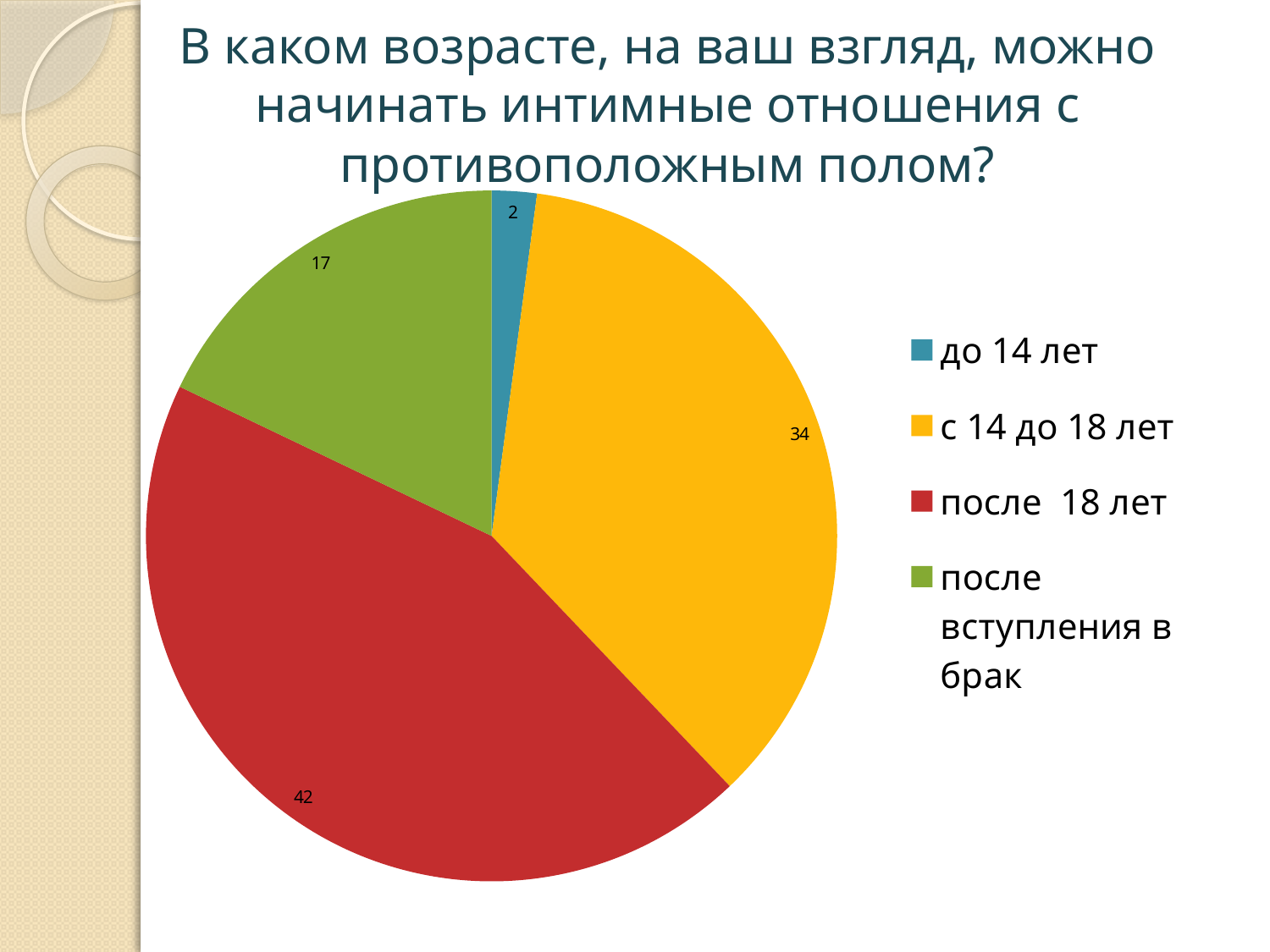
What colour is the slice for "после 18 лет"? red What value is shown for the slice "после вступления в брак"? 17 What kind of chart is shown on the slide? pie chart What value is shown for the slice "с 14 до 18 лет"? 34 What is the difference between the values for "после вступления в брак" and "до 14 лет"? 15 What value is shown for the slice "до 14 лет"? 2 Which category has the smallest slice of the pie? до 14 лет How many slices does the pie chart have? 4 Which category has the largest slice of the pie? после 18 лет What value is shown for the slice "после 18 лет"? 42 What is the difference between the values for "после 18 лет" and "с 14 до 18 лет"? 8 Which is larger: the value for "с 14 до 18 лет" or the value for "после вступления в брак"? с 14 до 18 лет